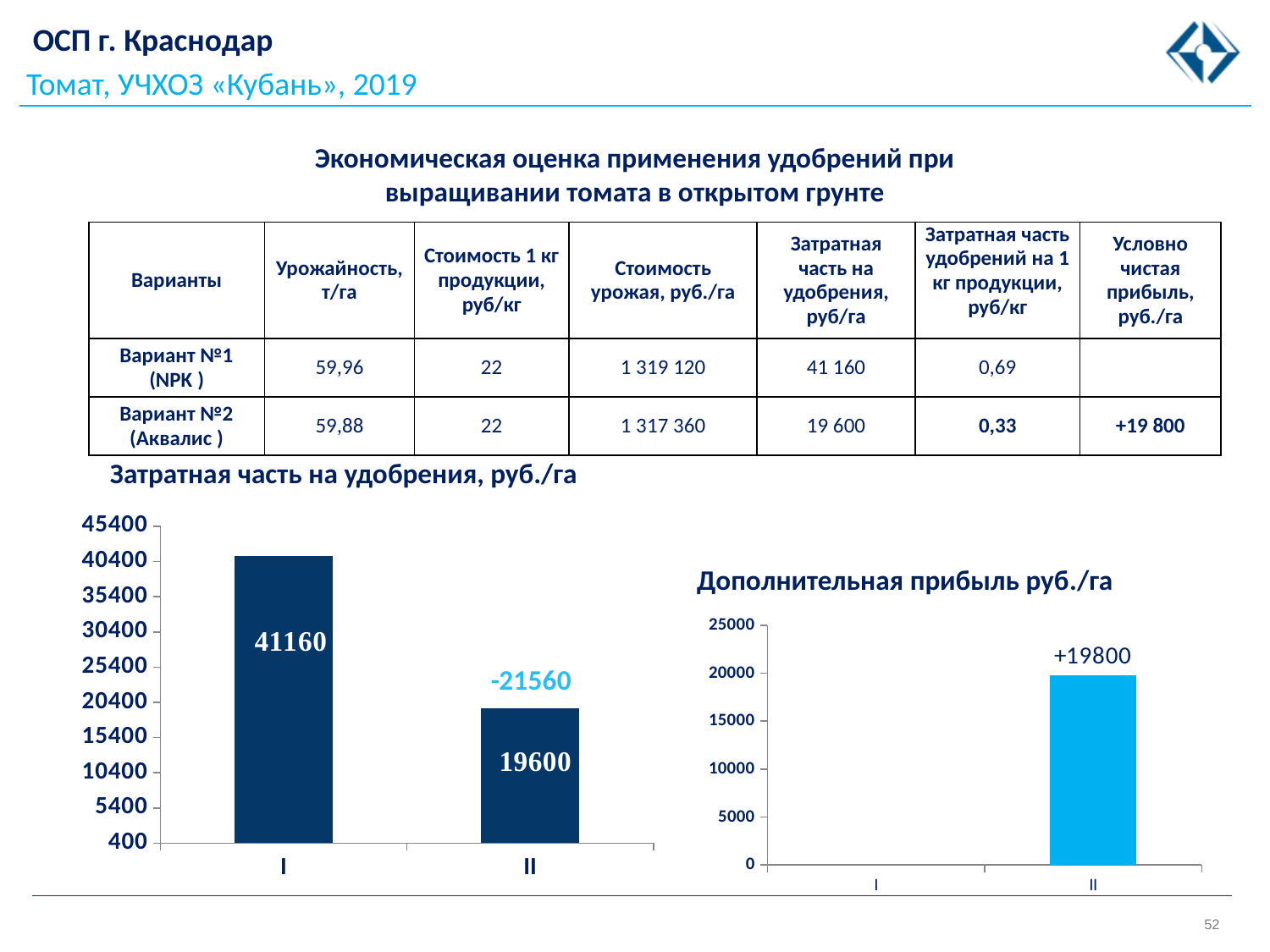
In the chart 'Затратная часть на удобрения, руб./га', what is the difference between the values for I and II? 21560 In the chart 'Затратная часть на удобрения, руб./га', which category has the lowest value? II In the chart 'Затратная часть на удобрения, руб./га', what is the value for category II? 19600 In the chart 'Затратная часть на удобрения, руб./га', how many categories are shown on the x axis? 2 In the chart 'Дополнительная прибыль руб./га', is the value for II greater or less than 15000? greater In the chart 'Дополнительная прибыль руб./га', what is the value labelled for category II? +19800 In the chart 'Затратная часть на удобрения, руб./га', which category has the highest value? I What kind of chart is 'Затратная часть на удобрения, руб./га'? bar chart In the chart 'Затратная часть на удобрения, руб./га', is the value for I greater or less than 35400? greater In the chart 'Дополнительная прибыль руб./га', which category has the higher value, I or II? II In the chart 'Затратная часть на удобрения, руб./га', what is the value for category I? 41160 What is the title of the chart on the right side of the slide? Дополнительная прибыль руб./га